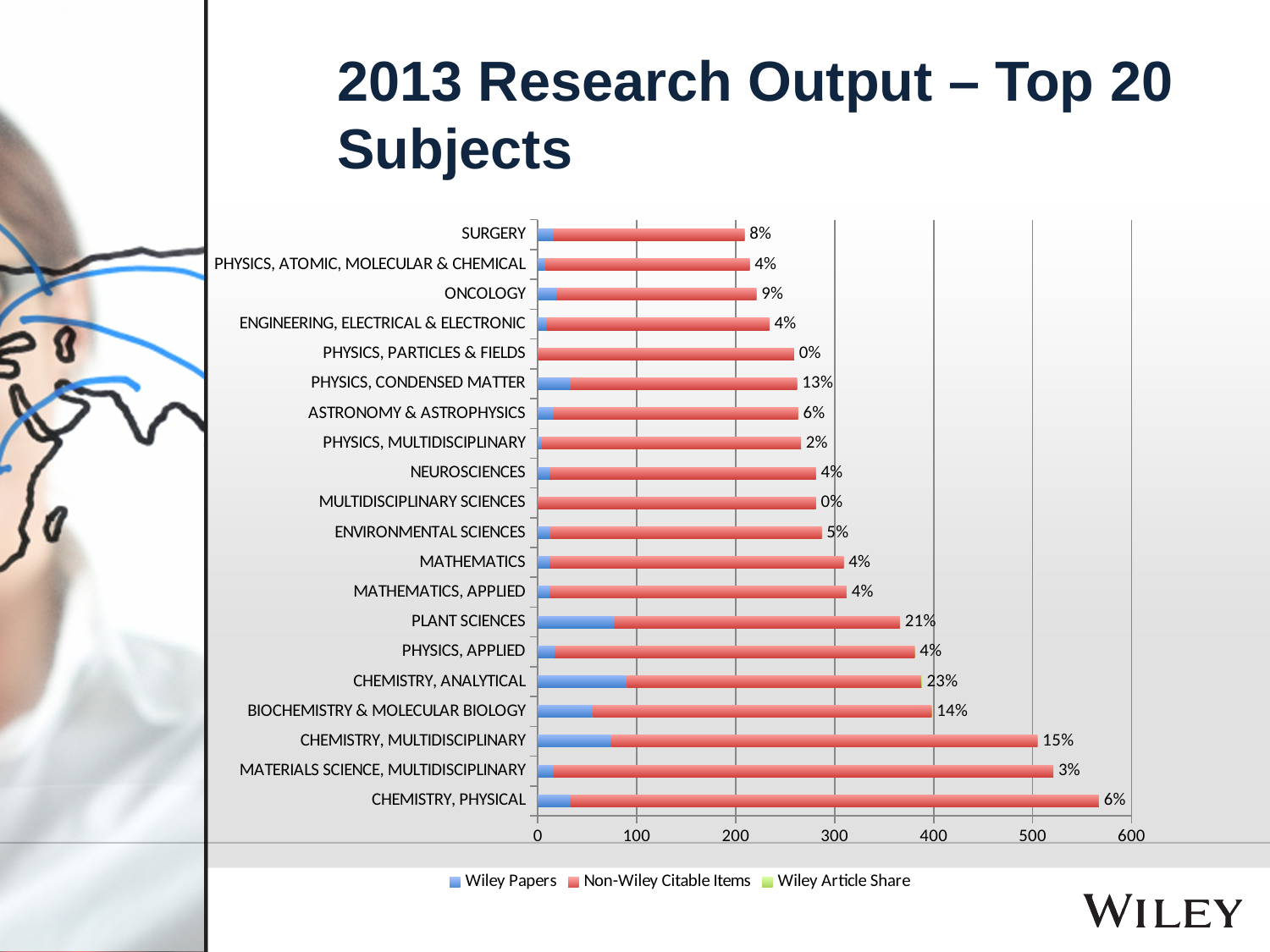
What is the difference between the Wiley Article Share for CHEMISTRY, ANALYTICAL and PLANT SCIENCES? 2% Which subject has the longest total bar in the chart? CHEMISTRY, PHYSICAL What is the Wiley Article Share shown for PLANT SCIENCES? 21% Is the total bar length for CHEMISTRY, PHYSICAL greater or less than 500? greater Is the total bar length for SURGERY greater or less than 300? less How many series does the chart legend list? 3 What kind of chart is shown on the slide? bar chart What is the Wiley Article Share shown for PHYSICS, CONDENSED MATTER? 13% What is the Wiley Article Share shown for CHEMISTRY, ANALYTICAL? 23% How many subject categories are plotted in the chart? 20 Which has a larger Wiley Article Share, BIOCHEMISTRY & MOLECULAR BIOLOGY or CHEMISTRY, MULTIDISCIPLINARY? CHEMISTRY, MULTIDISCIPLINARY Which subject has the highest Wiley Article Share label? CHEMISTRY, ANALYTICAL